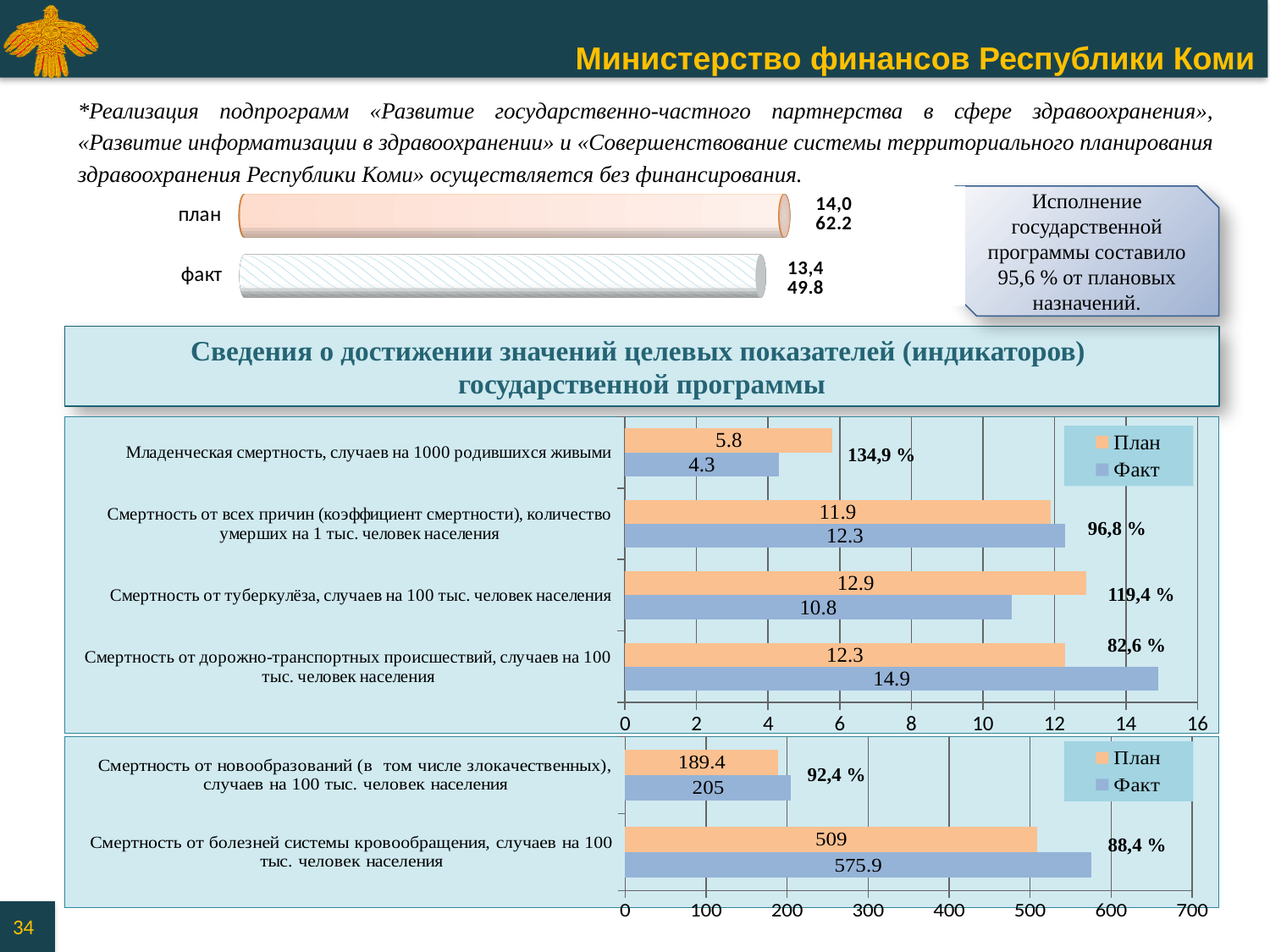
What kind of chart is the one with the 0–700 axis? Bar chart How many series does the legend list in the chart with the 0–700 axis? 2 How many categories are shown in the chart with the 0–16 axis? 4 In the chart with the 0–16 axis, what is the Факт value for Смертность от дорожно-транспортных происшествий, случаев на 100 тыс. человек населения? 14.9 In the chart with the 0–700 axis, what is the План value for Смертность от новообразований (в том числе злокачественных), случаев на 100 тыс. человек населения? 189.4 In the chart with the 0–16 axis, what is the difference between the План and Факт values for Смертность от туберкулёза, случаев на 100 тыс. человек населения? 2.1 In the chart with the 0–16 axis, what percentage is printed next to the bars for Смертность от всех причин (коэффициент смертности)? 96,8 % In the chart with the 0–700 axis, what is the Факт value for Смертность от болезней системы кровообращения, случаев на 100 тыс. человек населения? 575.9 In the chart with the 0–16 axis, what is the План value for Младенческая смертность, случаев на 1000 родившихся живыми? 5.8 In the chart with the 0–16 axis, which category has the highest Факт value? Смертность от дорожно-транспортных происшествий, случаев на 100 тыс. человек населения In the chart with the 0–16 axis, which category has the lowest План value? Младенческая смертность, случаев на 1000 родившихся живыми In the chart with the 0–700 axis, which is larger for Смертность от болезней системы кровообращения: the План value or the Факт value? Факт